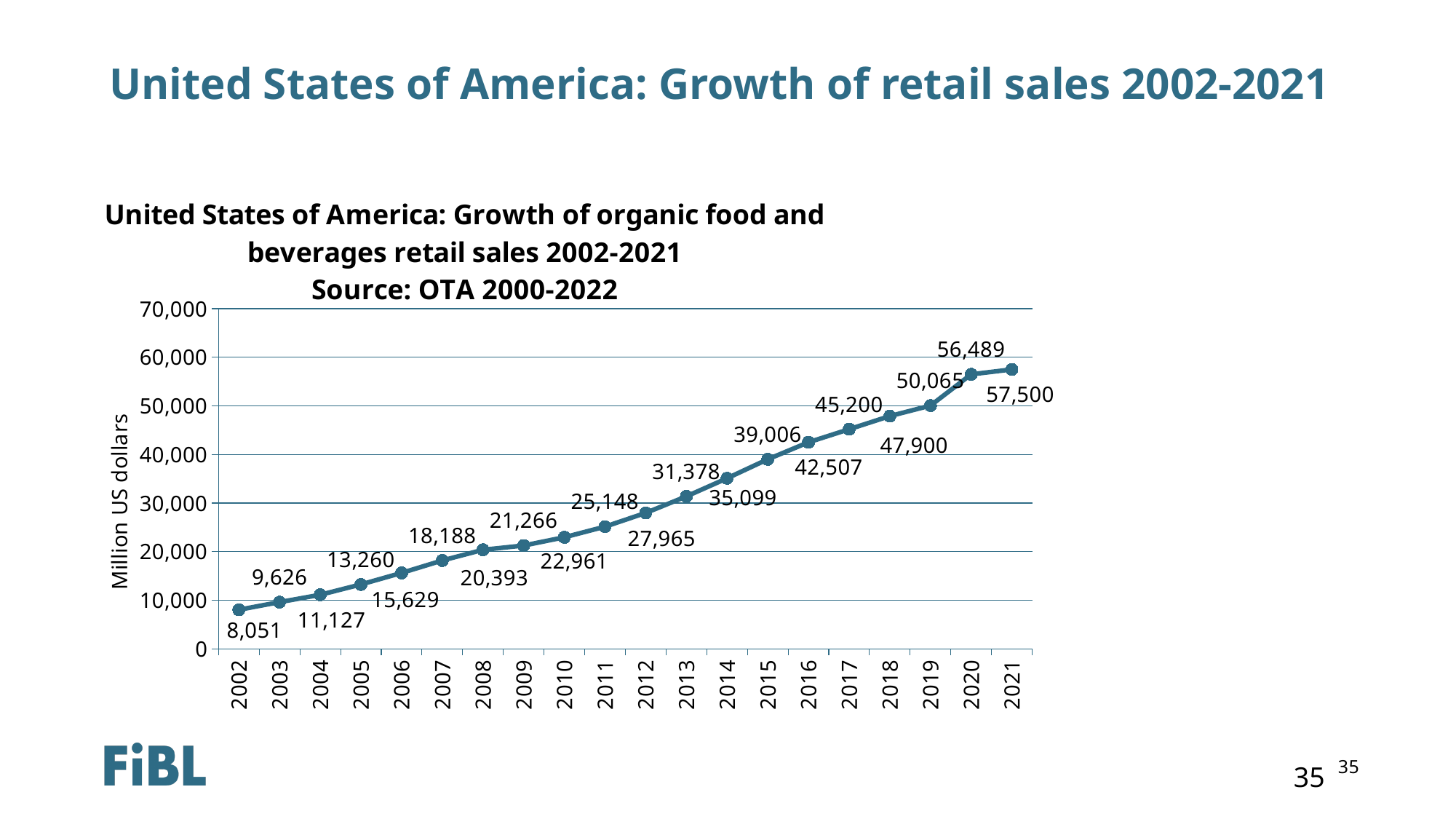
Is the retail sales value for 2014 greater or less than 30,000? greater What is the difference between the retail sales values for 2021 and 2020? 1,011 Which year has a larger retail sales value, 2010 or 2016? 2016 What kind of chart is shown on the slide? line chart What was the value of organic food and beverages retail sales in 2021? 57,500 Do the retail sales values rise or fall from 2002 to 2021? rise What was the value of organic food and beverages retail sales in 2002? 8,051 Which year has the highest retail sales value on the chart? 2021 Which year has the lowest retail sales value on the chart? 2002 What was the value of organic food and beverages retail sales in 2013? 31,378 How many years (data points) are plotted on the chart? 20 What is the difference between the retail sales values for 2020 and 2019? 6,424